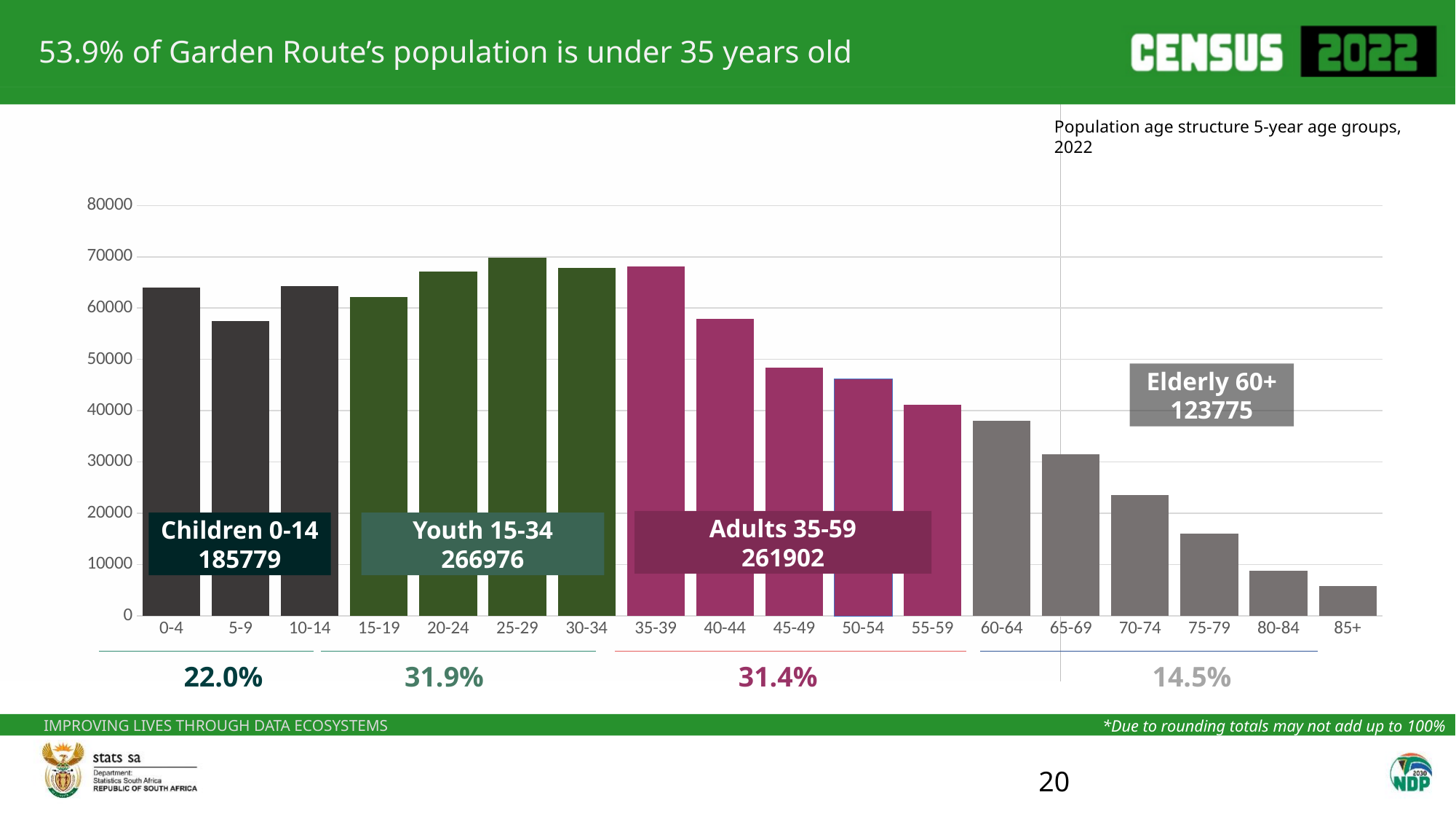
What is the title of the chart? Population age structure 5-year age groups, 2022 What is the total population for Children 0-14 shown on the chart? 185779 Do the values rise or fall along the x axis from 60-64 to 85+? Fall What is the total population for Youth 15-34 shown on the chart? 266976 What percentage of the population is Adults 35-59? 31.4% What percentage of the population is Elderly 60+? 14.5% Which group has the larger total, Youth 15-34 or Adults 35-59? Youth 15-34 Is the value for the 5-9 age group greater or less than 60000? less What is the difference between the Youth 15-34 total and the Adults 35-59 total? 5074 Which age group has the lowest population? 85+ How many 5-year age groups are plotted on the x axis? 18 What kind of chart is shown on the slide? Bar chart